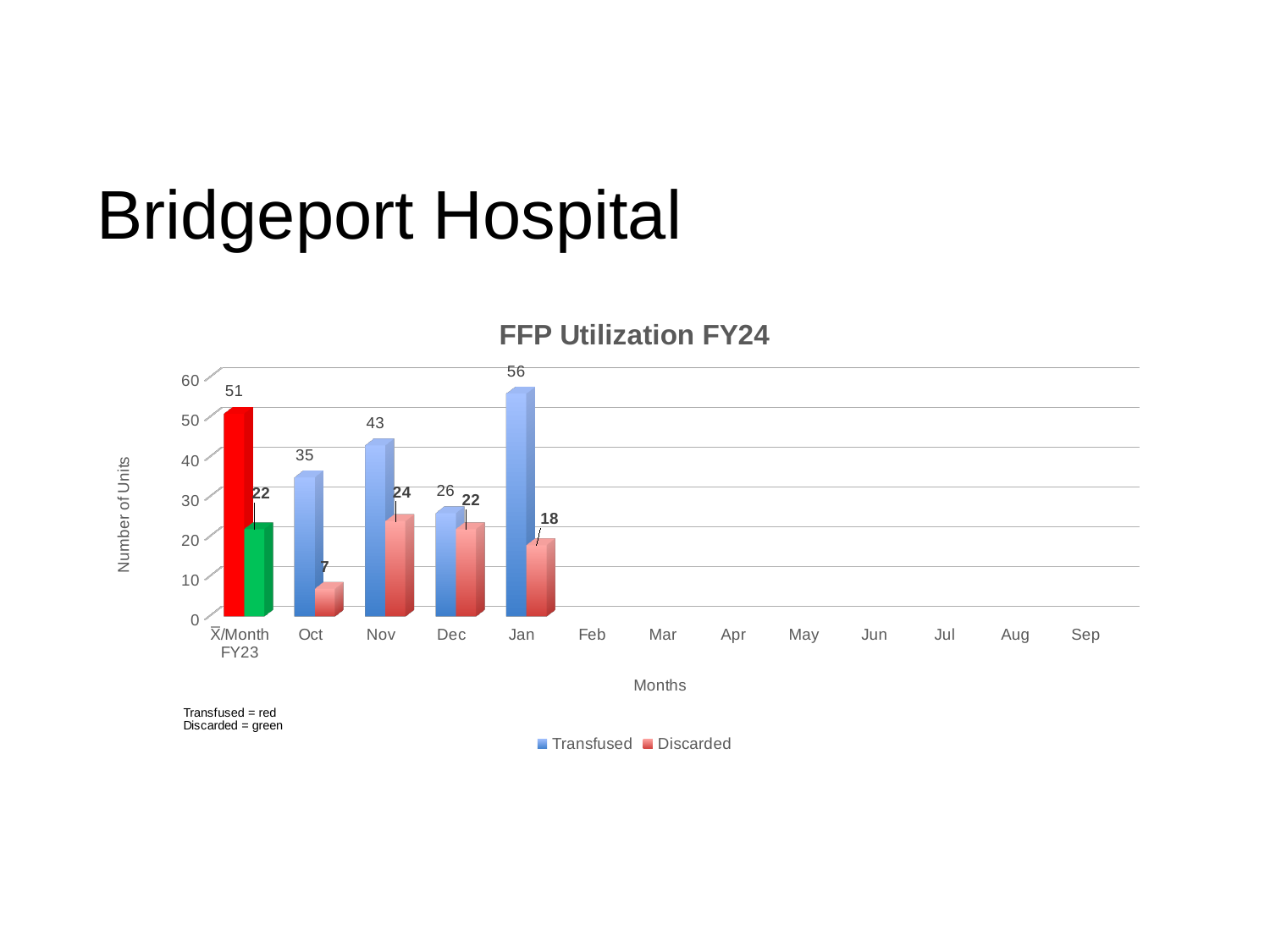
Which month from Oct to Jan has the highest Transfused value? Jan Is the Discarded value for Dec greater or less than 20? greater Which is larger, the Transfused value for Oct or the Transfused value for Dec? Oct What is the difference between the Transfused and Discarded values for Nov? 19 What is the Transfused value for Jan? 56 What is the Transfused value for the X/Month FY23 category? 51 Which category has the lowest Discarded value? Oct What is the Discarded value for Oct? 7 How many series does the legend list? 2 What is the label of the vertical axis? Number of Units What kind of chart is shown? Bar chart What is the title of the chart? FFP Utilization FY24